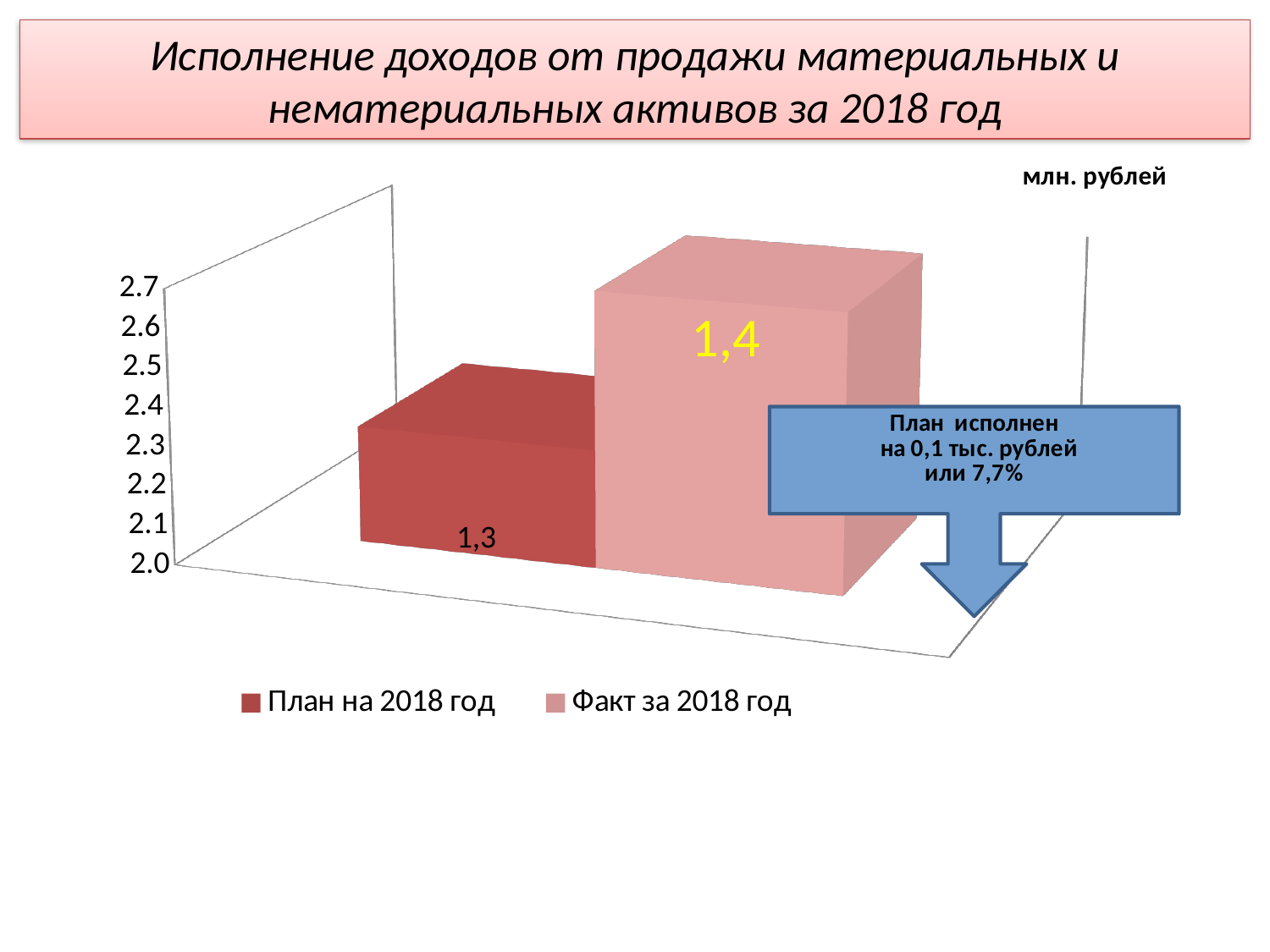
What type of chart is shown on the slide? bar chart How many series does the legend list? 2 Which bar is the lowest in the chart? План на 2018 год What is the value of the bar for Факт за 2018 год? 1,4 Which series has the higher value, План на 2018 год or Факт за 2018 год? Факт за 2018 год What is the title of the slide? Исполнение доходов от продажи материальных и нематериальных активов за 2018 год Which bar is the tallest in the chart? Факт за 2018 год What unit of measurement is indicated for the chart values? млн. рублей What is the value of the bar for План на 2018 год? 1,3 How many bars are plotted in the chart? 2 What is the difference between the Факт за 2018 год value and the План на 2018 год value? 0,1